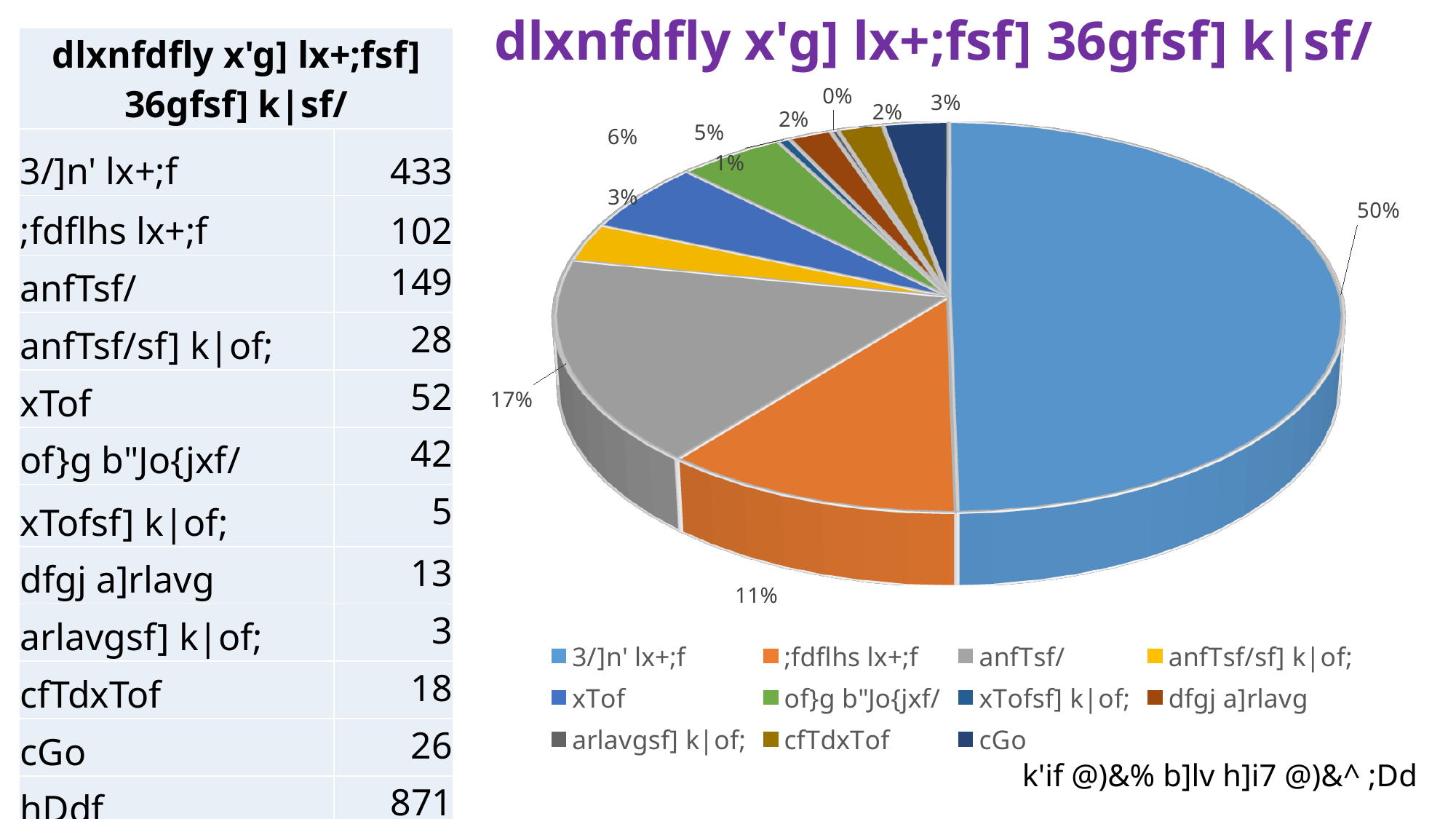
What kind of chart is shown on the slide? pie chart What percentage is shown for the anfTsf/ slice of the pie chart? 17% What is the difference in percentage points between the 3/]n' lx+;f slice and the anfTsf/ slice? 33 Which category has the largest slice of the pie chart? 3/]n' lx+;f How many entries does the legend of the pie chart list? 11 What colour is the largest slice of the pie chart? blue What percentage is shown for the xTof slice of the pie chart? 6% What percentage is shown for the largest slice of the pie chart? 50% What percentage is shown for the of}g b"Jo{jxf/ slice of the pie chart? 5% Which category is shown with a 0% label in the pie chart? arlavgsf] k|of; What percentage is shown for the ;fdflhs lx+;f slice of the pie chart? 11% Which slice is larger in the pie chart, anfTsf/ or ;fdflhs lx+;f? anfTsf/